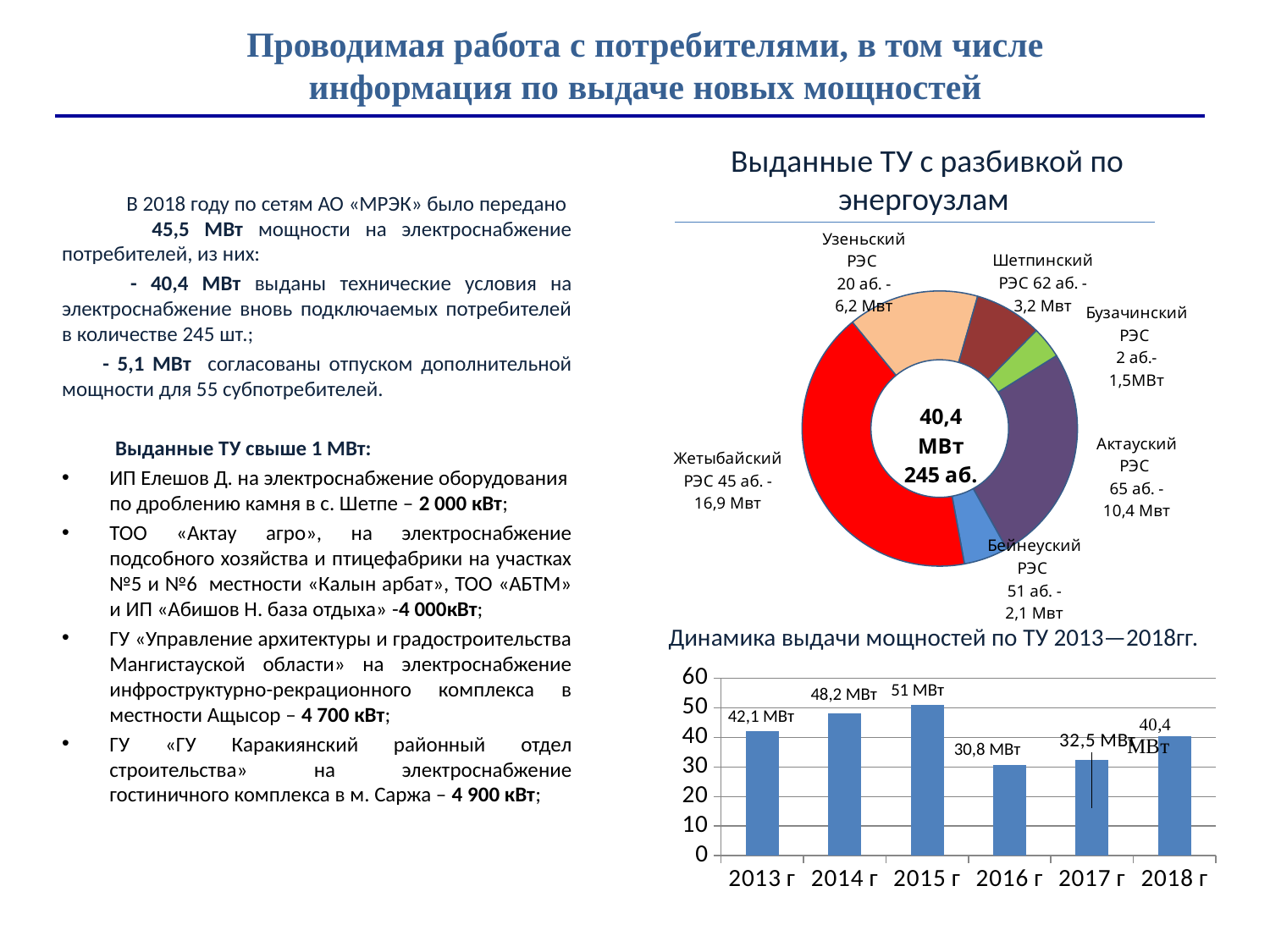
What kind of chart is 'Динамика выдачи мощностей по ТУ 2013—2018гг.'? bar chart In the doughnut chart 'Выданные ТУ с разбивкой по энергоузлам', what total is shown in the centre of the chart? 40,4 МВт 245 аб. In the bar chart 'Динамика выдачи мощностей по ТУ 2013—2018гг.', how many years are shown on the x axis? 6 In the bar chart 'Динамика выдачи мощностей по ТУ 2013—2018гг.', what is the value for 2016 г? 30,8 МВт In the doughnut chart 'Выданные ТУ с разбивкой по энергоузлам', how many MW are shown for Жетыбайский РЭС? 16,9 Мвт In the bar chart 'Динамика выдачи мощностей по ТУ 2013—2018гг.', which year has the highest value? 2015 г In the bar chart 'Динамика выдачи мощностей по ТУ 2013—2018гг.', do the values rise or fall from 2015 г to 2016 г? fall In the bar chart 'Динамика выдачи мощностей по ТУ 2013—2018гг.', which year has the lowest value? 2016 г In the bar chart 'Динамика выдачи мощностей по ТУ 2013—2018гг.', what is the value for 2015 г? 51 МВт In the bar chart 'Динамика выдачи мощностей по ТУ 2013—2018гг.', what is the difference between the values for 2014 г and 2013 г? 6,1 МВт In the bar chart 'Динамика выдачи мощностей по ТУ 2013—2018гг.', which is larger, the value for 2017 г or 2018 г? 2018 г In the doughnut chart 'Выданные ТУ с разбивкой по энергоузлам', which РЭС has the largest share of power? Жетыбайский РЭС